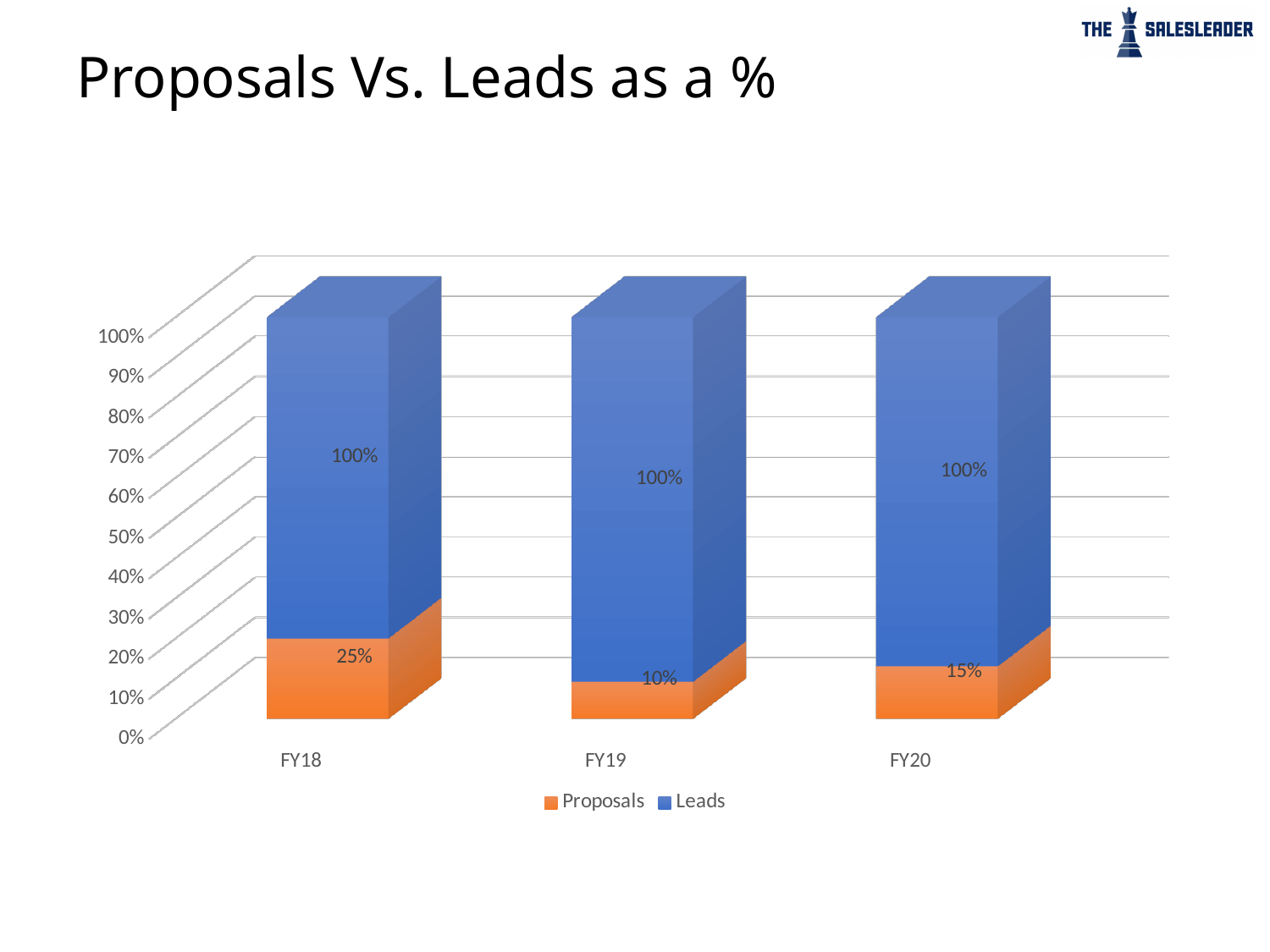
How many fiscal years are shown on the x axis? 3 What is the Proposals value for FY19? 10% Which is larger, the Proposals value for FY20 or for FY19? FY20 Which fiscal year has the highest Proposals value? FY18 What is the difference between the Proposals values for FY18 and FY19? 15% How many series does the legend list? 2 What is the Proposals value for FY18? 25% What is the title of the slide? Proposals Vs. Leads as a % What kind of chart is shown on the slide? Stacked bar chart What is the Proposals value for FY20? 15% What is the Leads value for FY19? 100% Which fiscal year has the lowest Proposals value? FY19